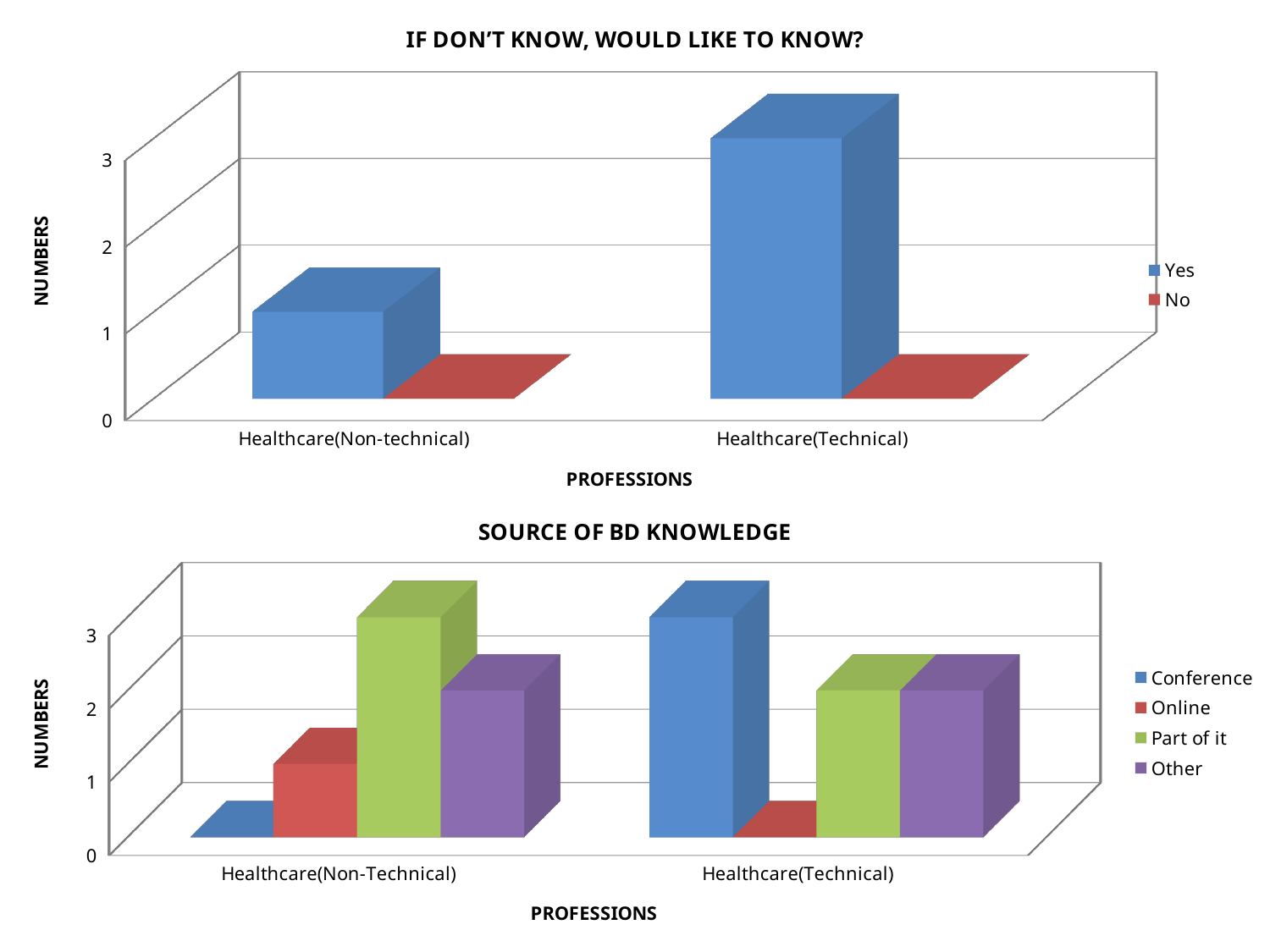
In the 'SOURCE OF BD KNOWLEDGE' chart, how many series does the legend list? 4 In the 'IF DON'T KNOW, WOULD LIKE TO KNOW?' chart, is the Yes value for Healthcare(Non-technical) greater or less than 2? less In the 'IF DON'T KNOW, WOULD LIKE TO KNOW?' chart, how many series does the legend list? 2 In the 'IF DON'T KNOW, WOULD LIKE TO KNOW?' chart, is the Yes value for Healthcare(Technical) greater or less than 2? greater In the 'SOURCE OF BD KNOWLEDGE' chart, is the Conference value for Healthcare(Technical) greater or less than 2? greater In the 'SOURCE OF BD KNOWLEDGE' chart, how many professions are shown on the x axis? 2 In the 'IF DON'T KNOW, WOULD LIKE TO KNOW?' chart, which profession has the higher Yes value? Healthcare(Technical) What kind of chart is the 'IF DON'T KNOW, WOULD LIKE TO KNOW?' chart? Bar chart In the 'SOURCE OF BD KNOWLEDGE' chart, which source has the highest value for Healthcare(Non-Technical)? Part of it In the 'SOURCE OF BD KNOWLEDGE' chart, which source has the highest value for Healthcare(Technical)? Conference In the 'IF DON'T KNOW, WOULD LIKE TO KNOW?' chart, what is the label of the y axis? NUMBERS In the 'SOURCE OF BD KNOWLEDGE' chart, for Healthcare(Non-Technical), which is larger: Part of it or Online? Part of it